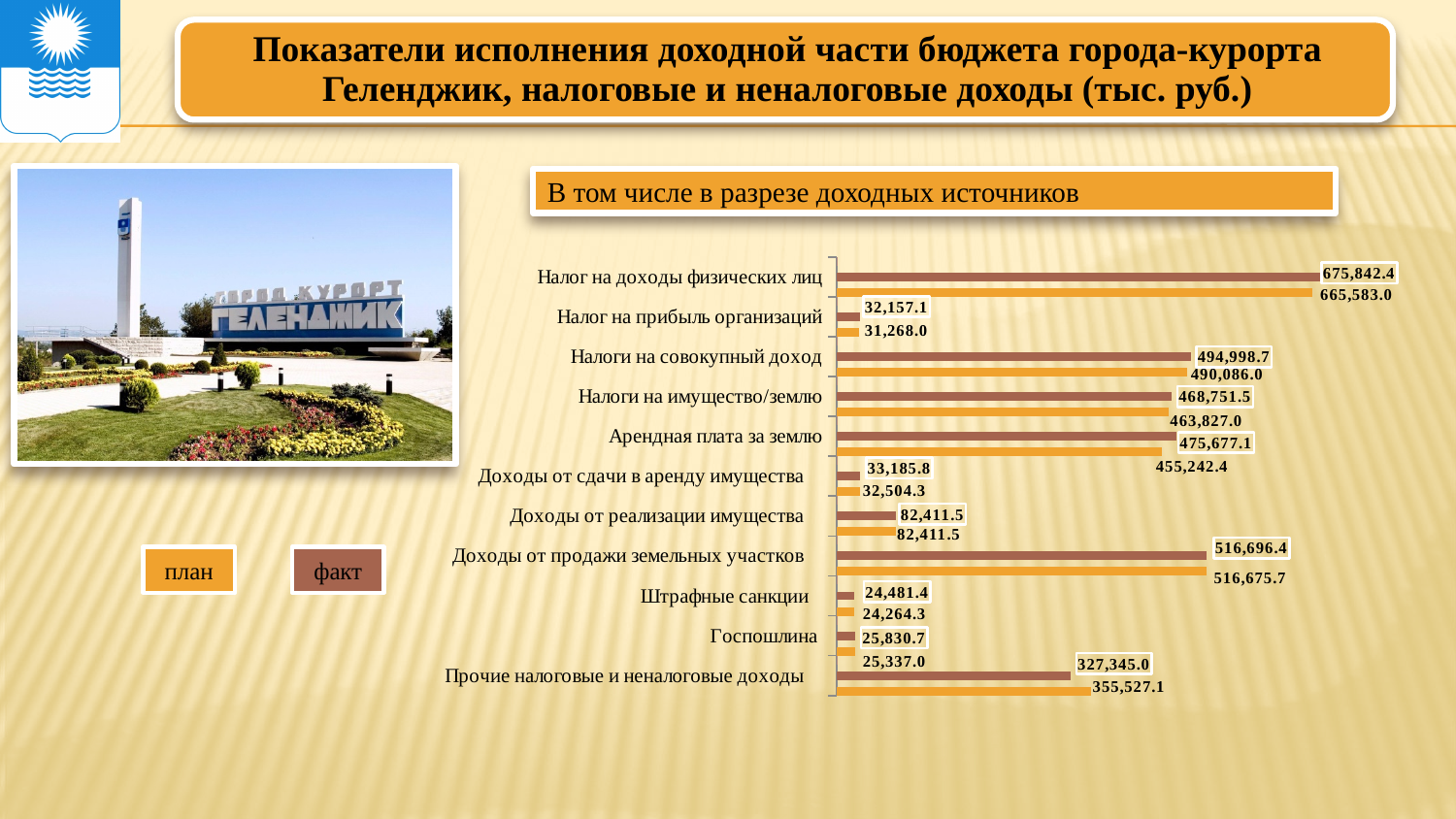
What type of chart is shown on the slide? bar chart What is the value of the orange (план) bar for 'Налог на доходы физических лиц'? 665,583.0 Which is larger for 'Прочие налоговые и неналоговые доходы': the brown (факт) bar or the orange (план) bar? the orange (план) bar How many series does the legend list? 2 What are the two legend entries shown on the slide? план and факт What is the value of the orange (план) bar for 'Прочие налоговые и неналоговые доходы'? 355,527.1 How many income source categories are plotted in the chart? 11 Which category has the highest brown (факт) value? Налог на доходы физических лиц What is the value of the brown (факт) bar for 'Госпошлина'? 25,830.7 What is the difference between the brown (факт) and orange (план) values for 'Арендная плата за землю'? 20,434.7 What is the value of the brown (факт) bar for 'Налог на доходы физических лиц'? 675,842.4 Which category has the lowest orange (план) value? Штрафные санкции